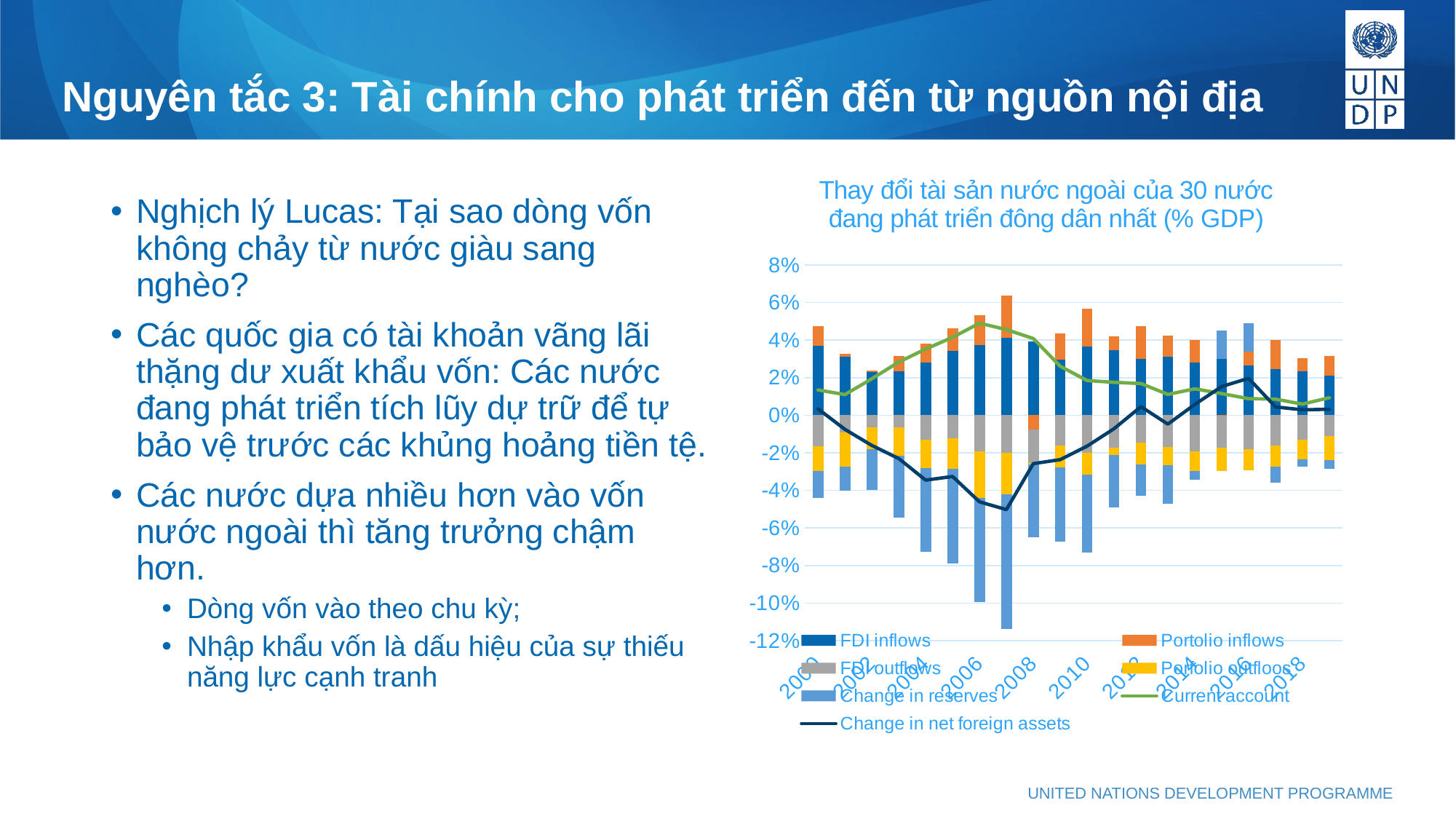
In which year does the Current account line reach its highest value? 2006 Which series is drawn in orange in the chart? Portolio inflows Is the Current account value for 2006 greater or less than 4%? greater What kind of chart is shown on the slide? A stacked bar chart combined with line series What is the title of the chart? Thay đổi tài sản nước ngoài của 30 nước đang phát triển đông dân nhất (% GDP) Is the Change in reserves value for 2007 greater or less than -10%? greater How many series does the chart legend list? 7 In which year does the Change in net foreign assets line reach its lowest value? 2007 Which year has the lower Change in reserves value, 2000 or 2007? 2007 Does the Current account line rise or fall between 2006 and 2010? fall Is the Change in net foreign assets value for 2007 greater or less than -4%? less